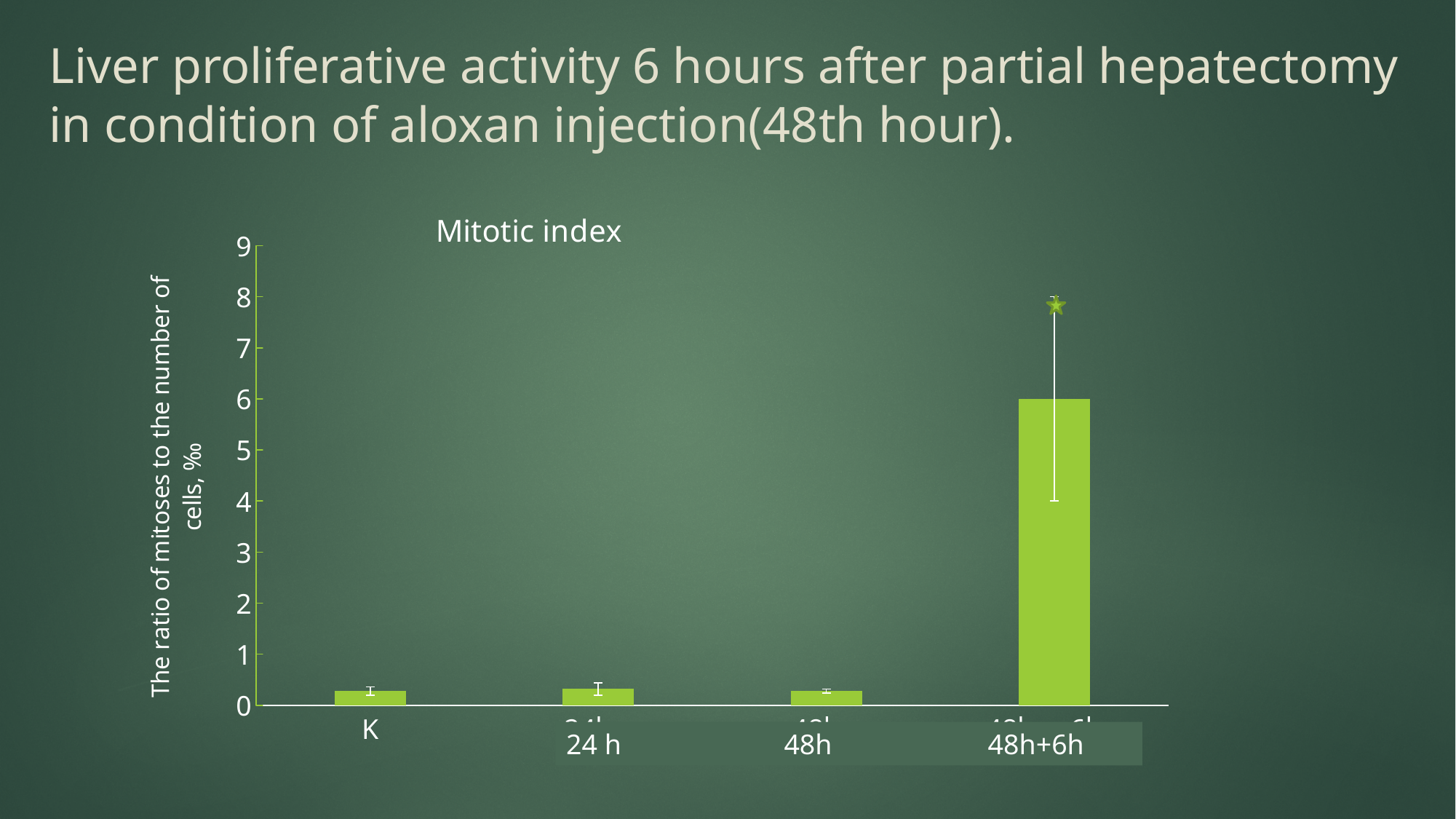
Is the value for 24 h greater or less than 1? less How many categories are shown on the x axis of the chart? 4 Is the value for K greater or less than 1? less What is the label of the vertical axis? The ratio of mitoses to the number of cells, ‰ What is the mitotic index value for 48h+6h? 6 What is the title of the chart? Mitotic index What type of chart is shown on the slide? bar chart Is the value for 48h greater or less than 2? less Which category has the highest mitotic index? 48h+6h Which is larger, the value for 48h+6h or the value for 48h? 48h+6h What is the highest value shown on the vertical axis? 9